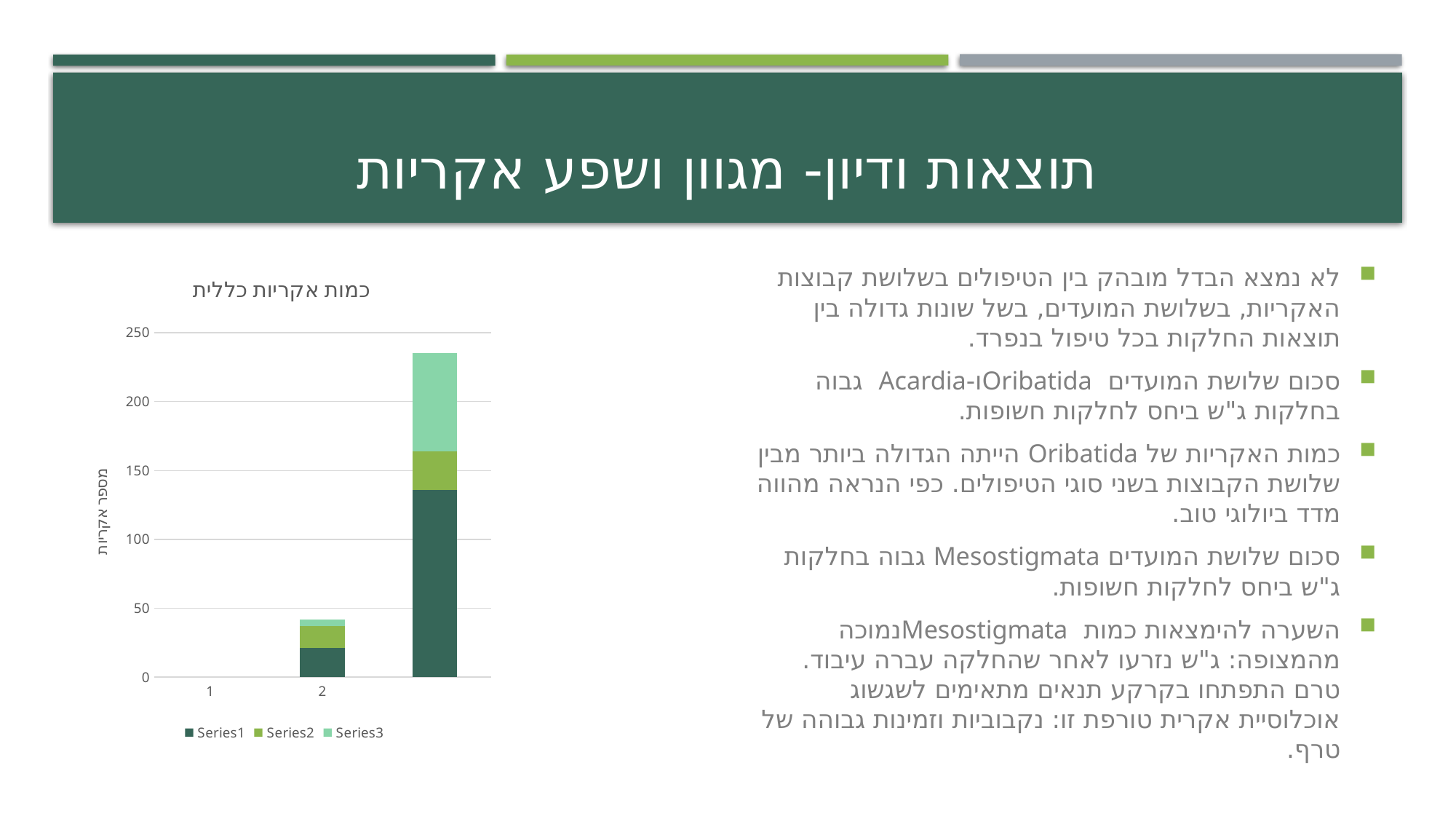
Is the Series1 value in the rightmost bar greater or less than 100? greater Is the total of the stacked bar for category 2 greater or less than 50? less What is the title of the chart? כמות אקריות כללית What is the highest value shown on the vertical axis? 250 Is the total of the rightmost stacked bar greater or less than 200? greater Which is larger: the total of the bar for category 2 or the total of the rightmost bar? the rightmost bar What kind of chart is shown on the slide? stacked bar chart Do the bar totals rise or fall from left to right along the x axis? rise What is the label on the chart's vertical axis? מספר אקריות Which bar has the highest total value? the rightmost bar How many series does the chart legend list? 3